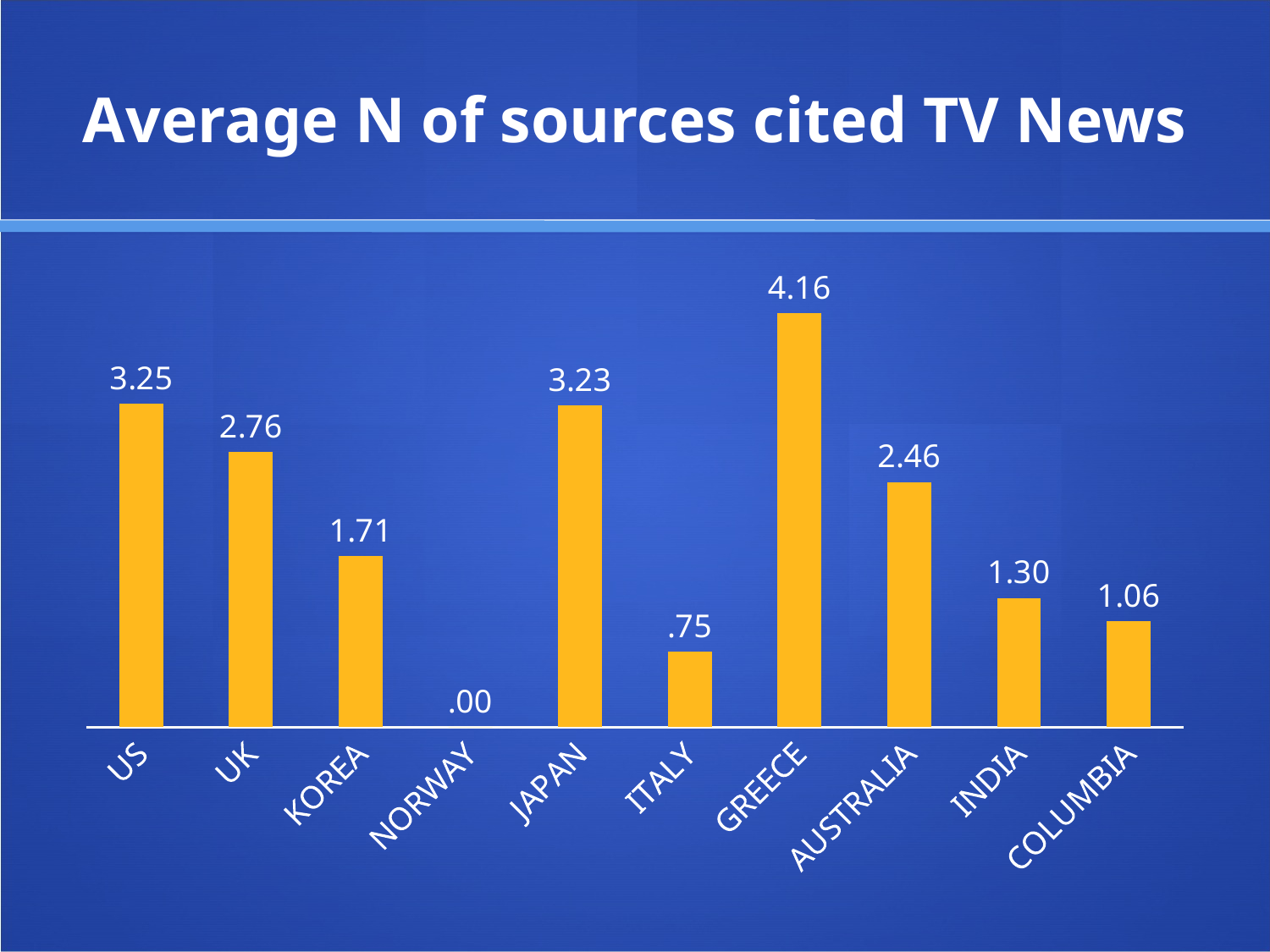
What is the value for Italy? .75 What is the value for Greece? 4.16 What is the difference between the values for US and UK? .49 Which country has the highest value? Greece What kind of chart is shown on the slide? Bar chart Which is larger, the value for India or the value for Columbia? India What is the value for Korea? 1.71 What is the title of the chart? Average N of sources cited TV News What is the value for Norway? .00 What is the difference between the values for Greece and Australia? 1.70 Which country has the lowest value? Norway How many countries are shown on the chart? 10